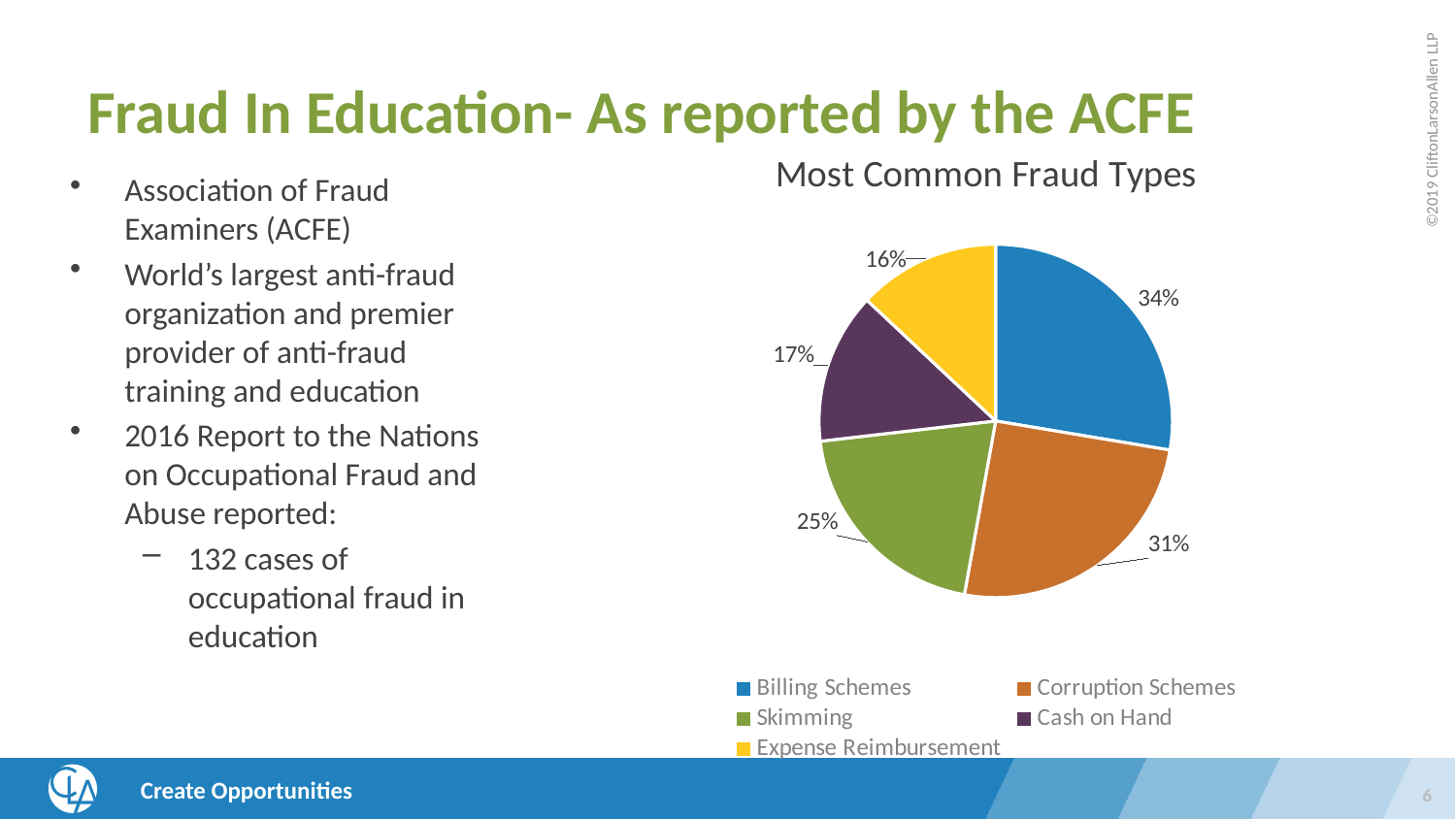
How many fraud types are listed in the legend? 5 What percentage is shown for Billing Schemes? 34% What percentage is shown for Skimming? 25% What type of chart is shown on the slide? Pie chart What is the difference in percentage points between Billing Schemes and Skimming? 9 What is the title of the chart? Most Common Fraud Types Which fraud type has the smallest slice of the pie? Expense Reimbursement Which fraud type has the largest slice of the pie? Billing Schemes Which is larger, Corruption Schemes or Skimming? Corruption Schemes What percentage is shown for Expense Reimbursement? 16% What percentage is shown for Corruption Schemes? 31% What percentage is shown for Cash on Hand? 17%